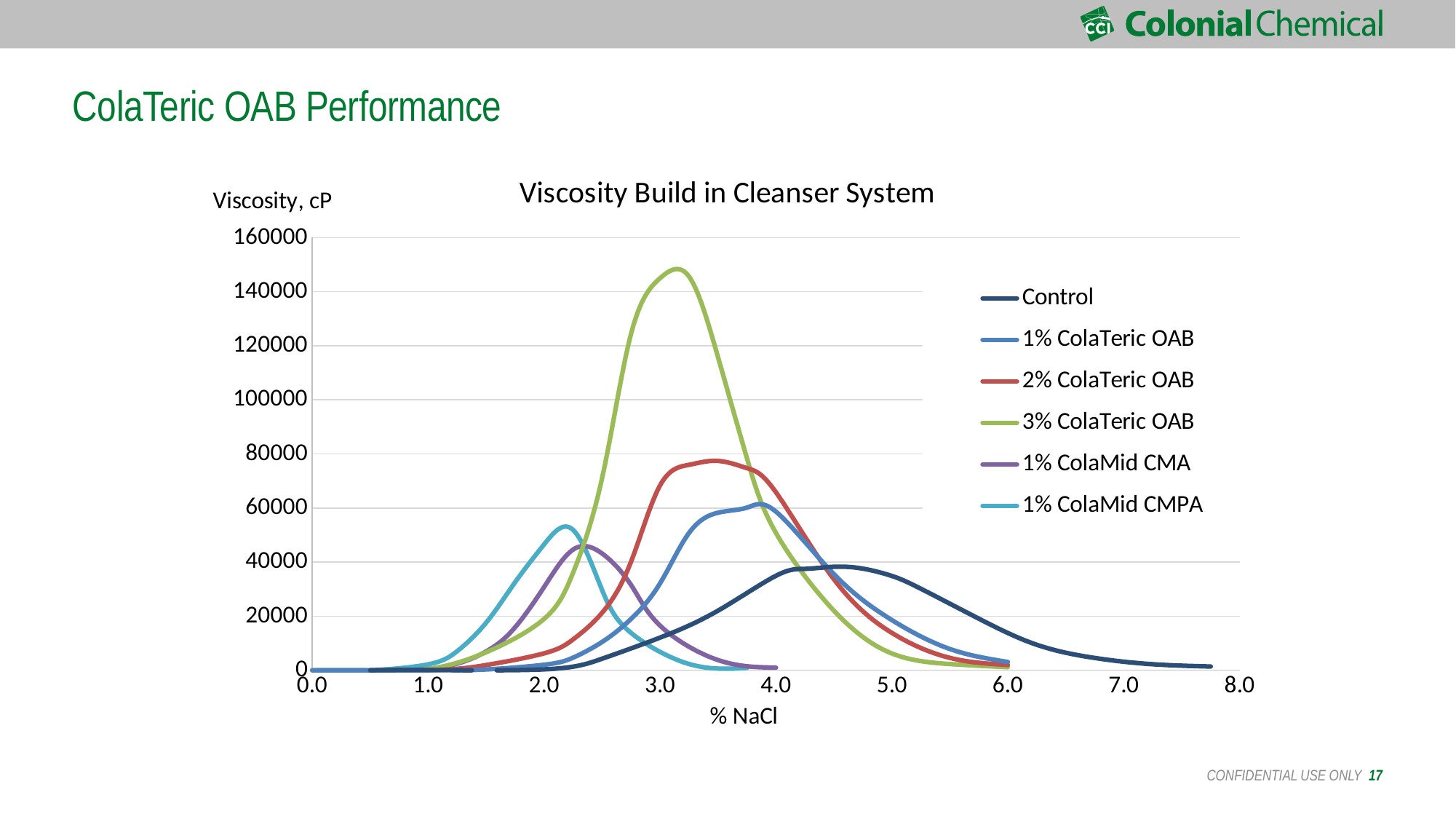
Which series reaches its peak viscosity at the highest % NaCl? Control What kind of chart is shown on the slide? Line chart What is the title of the chart? Viscosity Build in Cleanser System Is the peak viscosity of 3% ColaTeric OAB greater or less than 140000? greater Which series has a higher peak viscosity, 1% ColaTeric OAB or 2% ColaTeric OAB? 2% ColaTeric OAB Is the peak viscosity of 2% ColaTeric OAB greater or less than 60000? greater Which series reaches the highest viscosity? 3% ColaTeric OAB Which series has the lowest peak viscosity? Control Is the peak viscosity of 1% ColaMid CMPA greater or less than 40000? greater What is the label of the x axis? % NaCl How many series does the legend list? 6